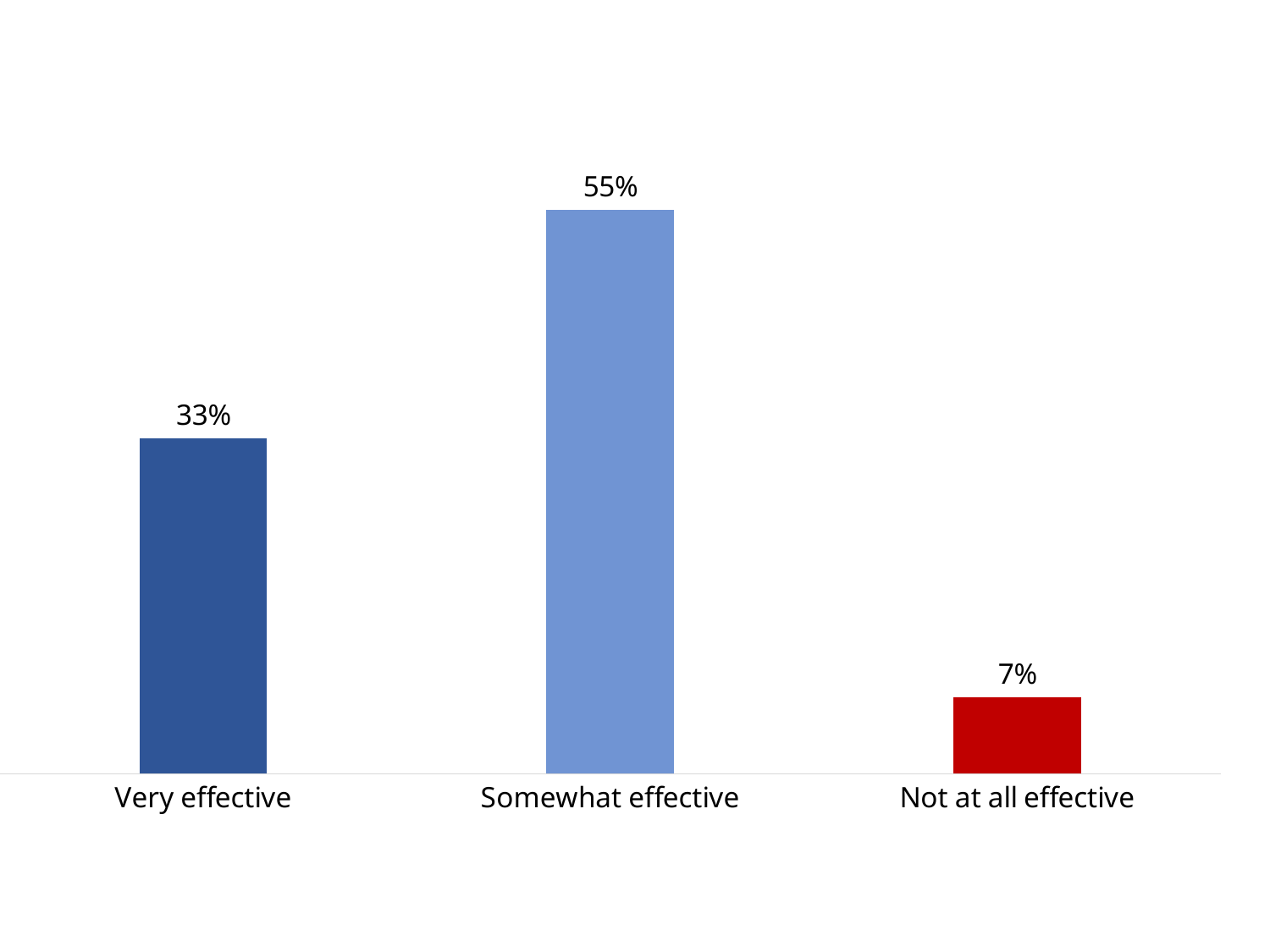
Which is larger, the value for Very effective or the value for Not at all effective? Very effective What is the difference between the values for Somewhat effective and Very effective? 22% What colour is the bar for Not at all effective? Red Which category has the highest value? Somewhat effective Which category has the lowest value? Not at all effective What is the value for Not at all effective? 7% How many categories are shown in the chart? 3 What is the value for Very effective? 33% What is the total of the three values shown in the chart? 95% What is the difference between the values for Very effective and Not at all effective? 26% What kind of chart is shown on the slide? Bar chart What is the value for Somewhat effective? 55%